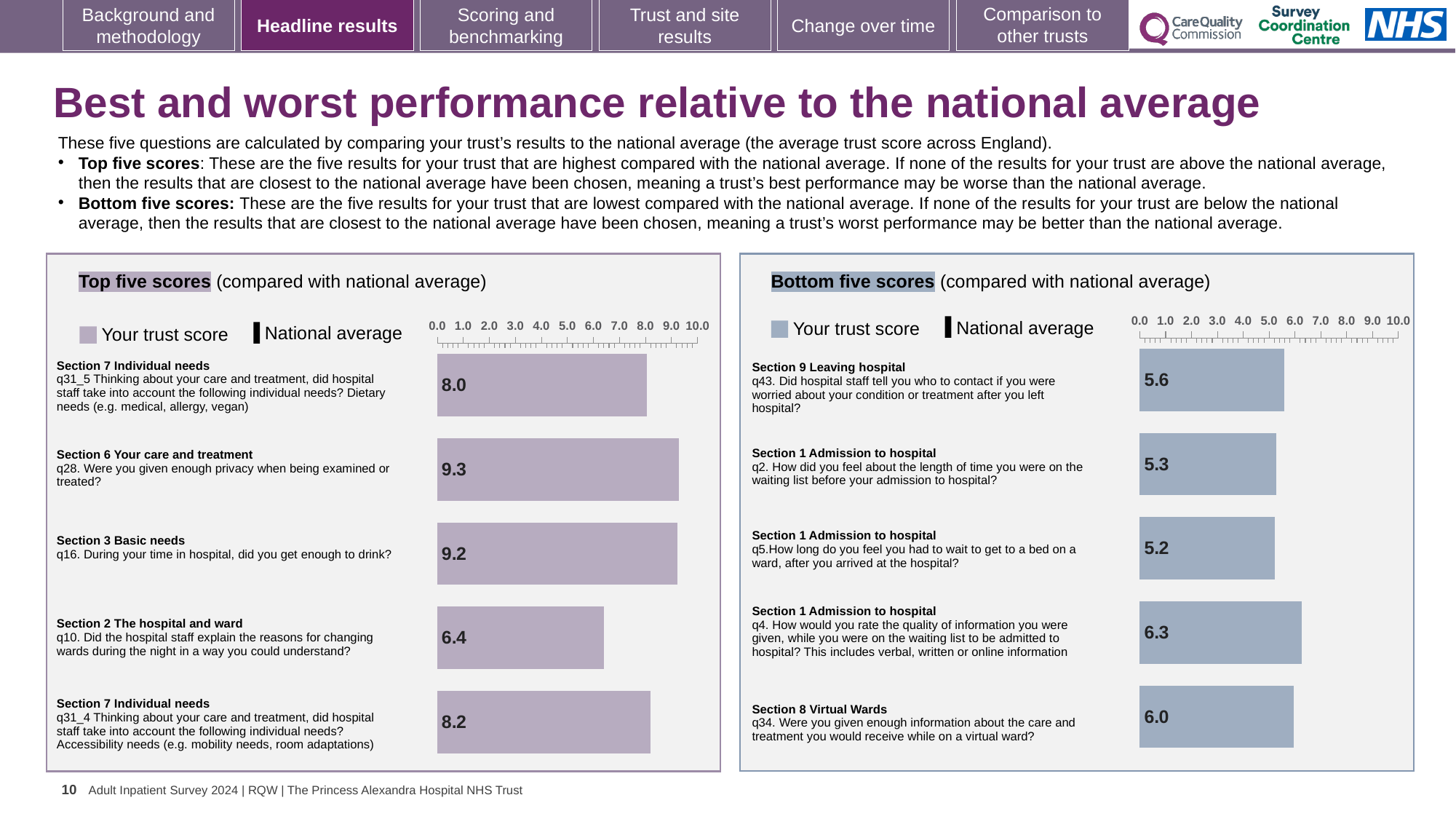
In the Top five scores chart, which has the larger trust score: q31_5 (Dietary needs) or q31_4 (Accessibility needs)? q31_4 (Accessibility needs) In the Top five scores chart, what is the difference between the trust scores for q28 and q10? 2.9 In the Bottom five scores chart, what is the trust score for q43 (Did hospital staff tell you who to contact if you were worried about your condition or treatment after you left hospital?)? 5.6 How many series does the legend of the Top five scores chart list? 2 In the Top five scores chart, what is the trust score for q10 (Did the hospital staff explain the reasons for changing wards during the night in a way you could understand?)? 6.4 In the Bottom five scores chart, what is the trust score for q34 (Were you given enough information about the care and treatment you would receive while on a virtual ward?)? 6.0 In the Top five scores chart, which question has the highest trust score? q28. Were you given enough privacy when being examined or treated? In the Top five scores chart, what is the trust score for q28 (Were you given enough privacy when being examined or treated?)? 9.3 In the Bottom five scores chart, which question has the lowest trust score? q5. How long do you feel you had to wait to get to a bed on a ward, after you arrived at the hospital? How many questions are shown in the Bottom five scores chart? 5 In the Bottom five scores chart, what is the difference between the trust scores for q4 and q5? 1.1 What kind of chart is the Bottom five scores chart? Bar chart